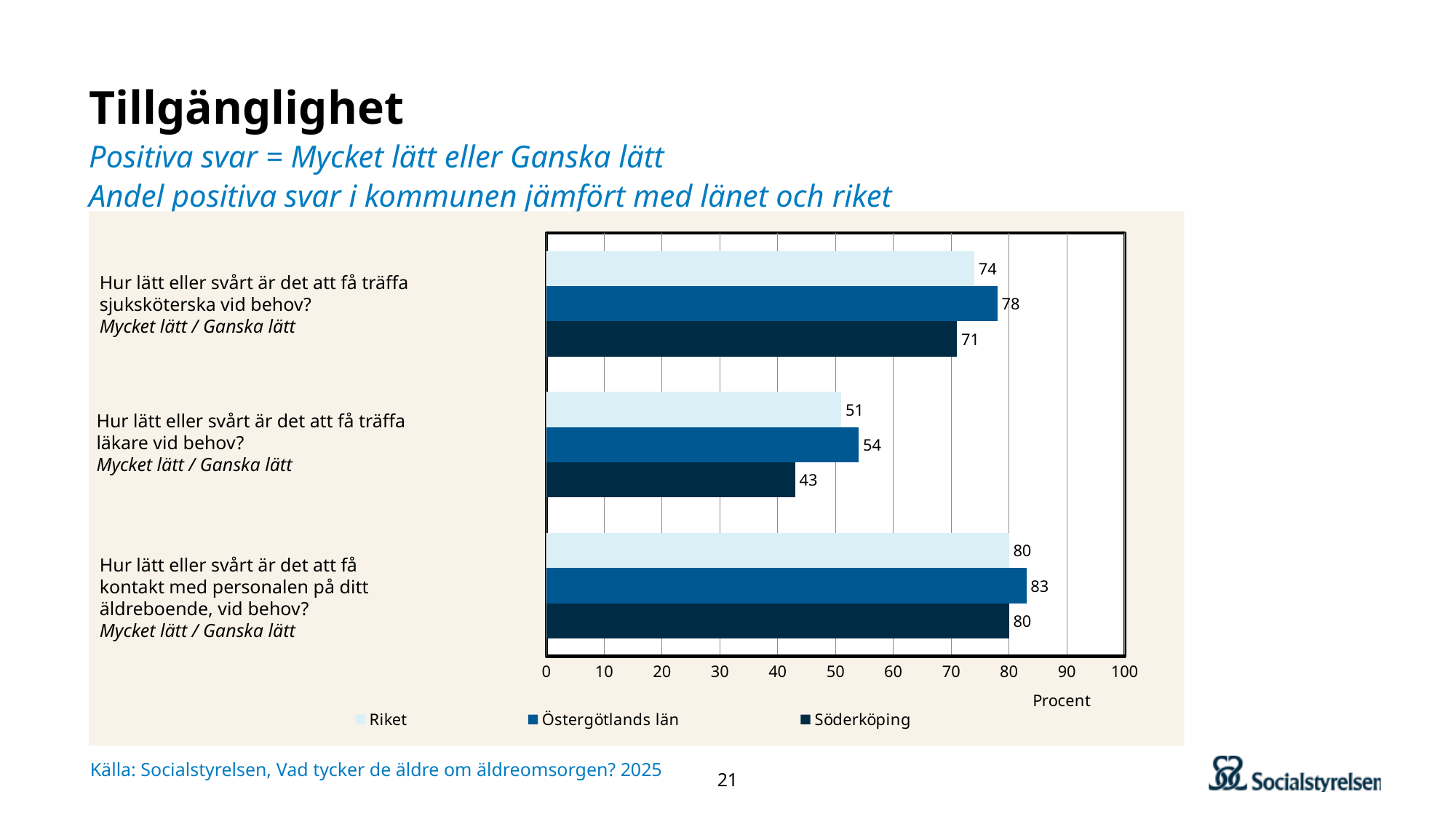
How many questions (categories) are shown in the chart? 3 Which is larger: the Riket value or the Söderköping value on the question about meeting a nurse (sjuksköterska)? Riket How many series does the legend list? 3 What is the value for Söderköping on the question about how easy it is to meet a nurse (sjuksköterska) when needed? 71 Which series has the lowest value on the question about meeting a nurse (sjuksköterska) when needed? Söderköping What unit is shown on the horizontal axis of the chart? Procent What is the value for Östergötlands län on the question about how easy it is to meet a doctor (läkare) when needed? 54 What kind of chart is shown on the slide? bar chart Is the Söderköping value for meeting a doctor (läkare) greater or less than 50? less What is the difference between Östergötlands län and Söderköping on the question about meeting a doctor (läkare) when needed? 11 What is the value for Riket on the question about getting in contact with staff at the elderly home (kontakt med personalen)? 80 Which series has the highest value on the question about meeting a doctor (läkare) when needed? Östergötlands län